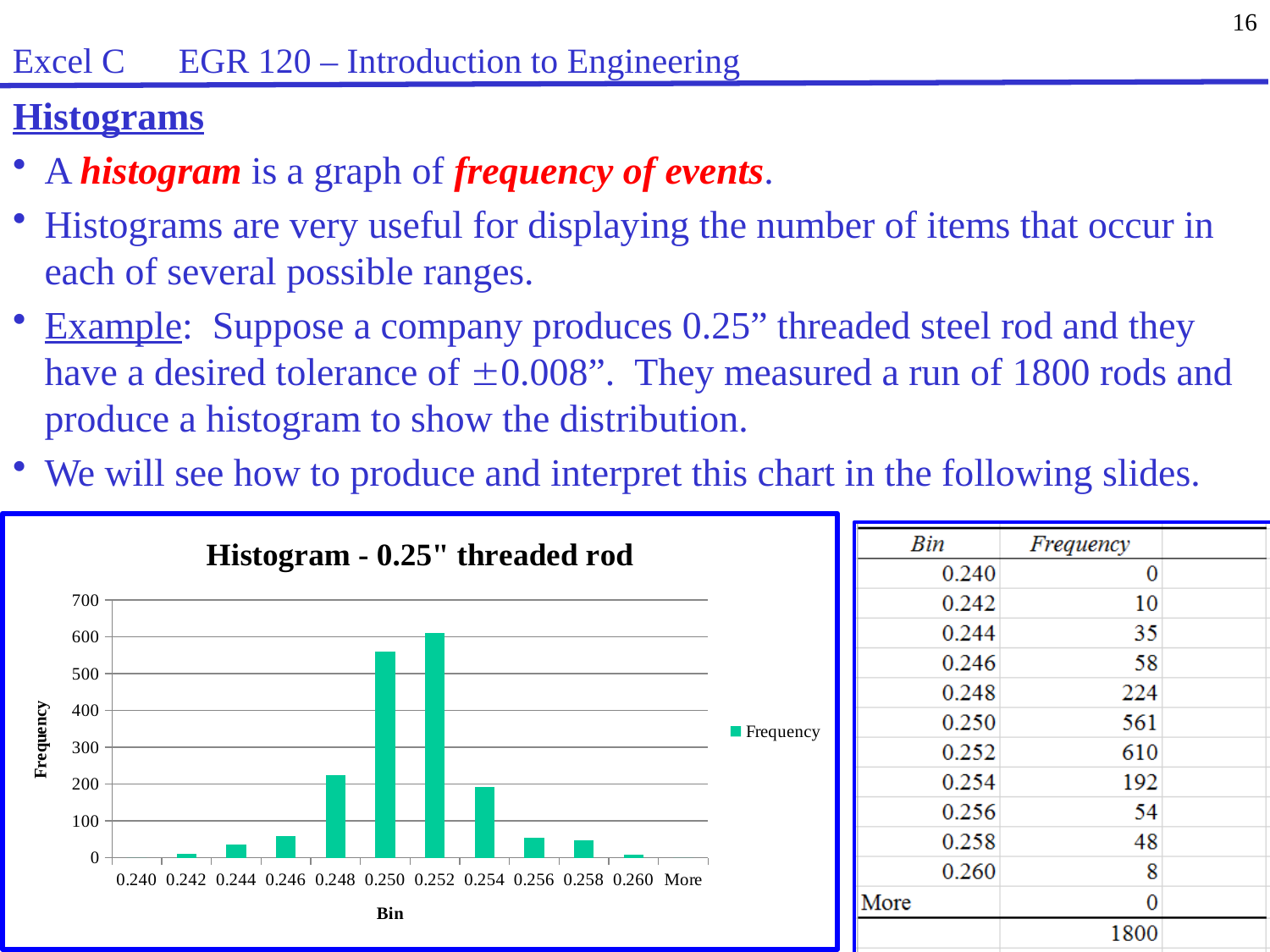
Which bin has a larger frequency, 0.250 or 0.254? 0.250 What type of chart is shown on the slide? bar chart What is the frequency for the 0.252 bin? 610 How many bins (categories) are shown along the x axis of the chart? 12 Is the frequency for the 0.248 bin greater or less than 200? greater What is the frequency for the 0.250 bin? 561 What is the difference in frequency between the 0.252 bin and the 0.250 bin? 49 What is the label on the y axis of the chart? Frequency What is the frequency for the 0.248 bin? 224 What is the title of the chart? Histogram - 0.25" threaded rod Which bin has the highest frequency? 0.252 How many series does the chart legend list? 1